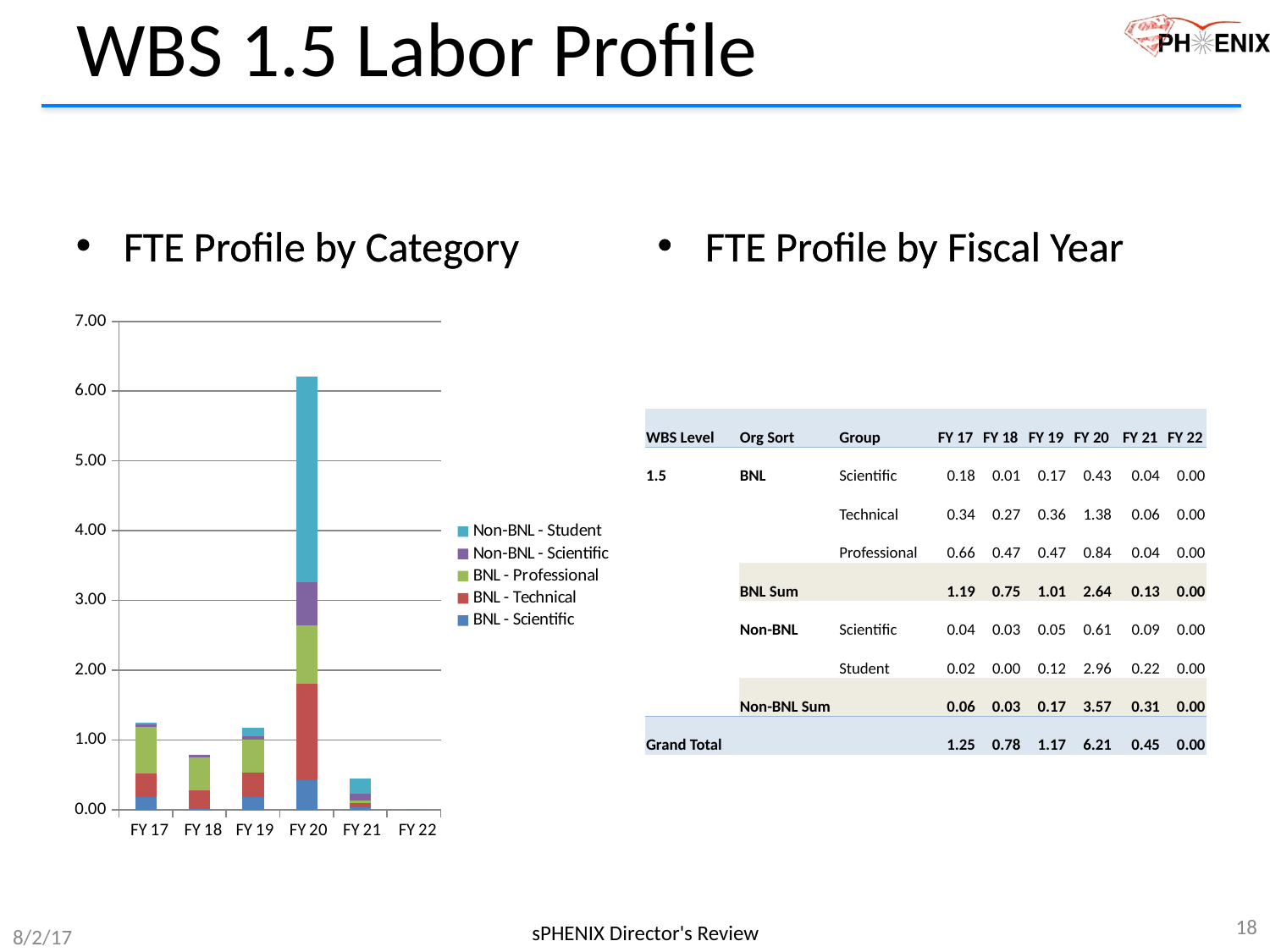
Which fiscal year has the lowest total in the chart? FY 22 Is the total stacked bar for FY 18 greater or less than 1.00? less According to the table on the slide, what is the BNL Technical FTE value for FY 20? 1.38 According to the table on the slide, what is the Grand Total FTE for FY 20? 6.21 Which stacked bar is taller, FY 17 or FY 18? FY 17 Which series is listed first (at the top) in the chart legend? Non-BNL - Student How many fiscal years are shown along the x axis of the chart? 6 Which fiscal year has the tallest stacked bar in the chart? FY 20 Is the total stacked bar for FY 20 greater or less than 5.00? greater What kind of chart is shown on the slide? bar chart Do the stacked bar totals rise or fall from FY 20 to FY 22? fall How many series does the legend of the chart list? 5